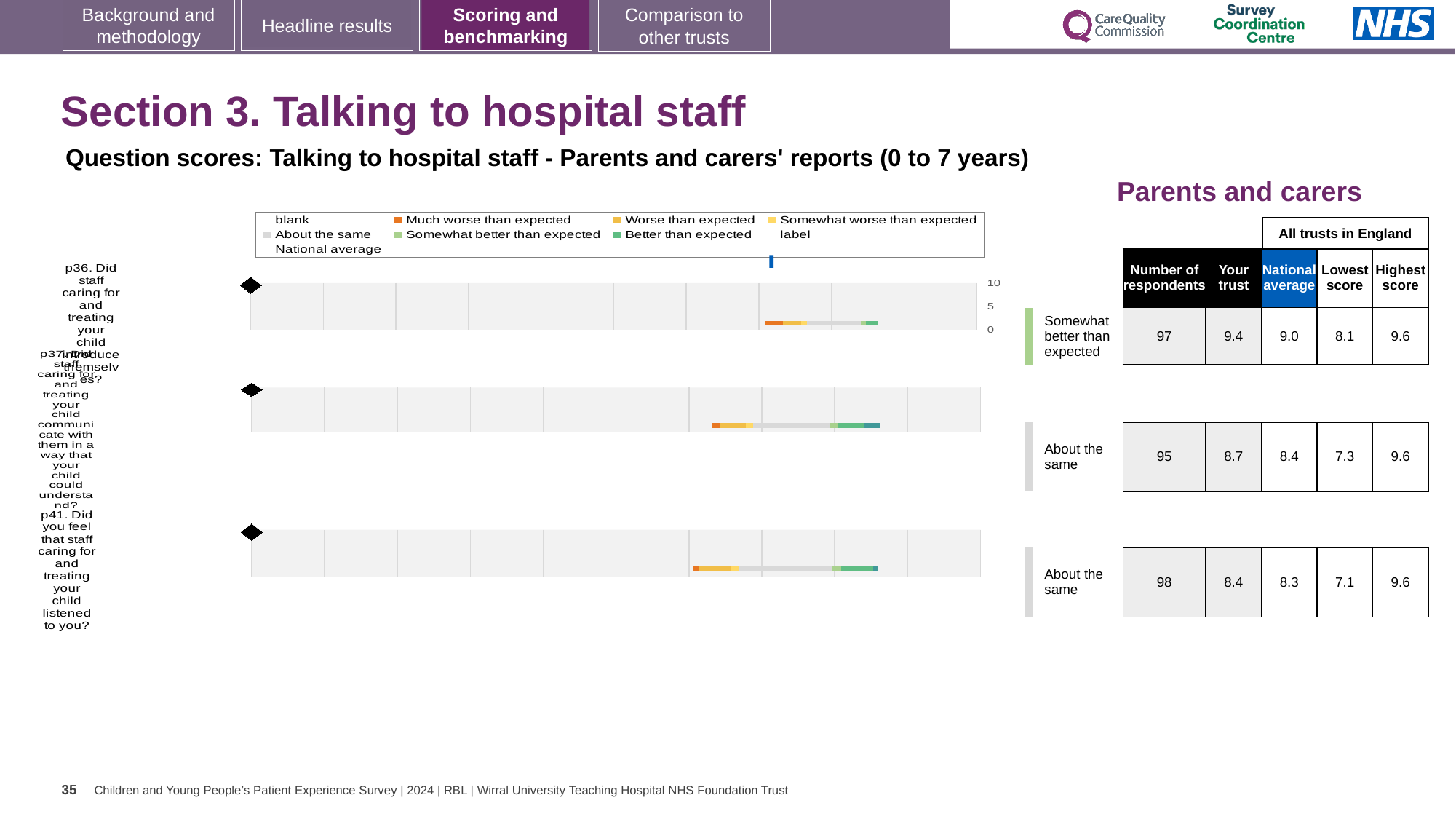
What colour represents 'Much worse than expected' in the legend? orange What is the difference between the 'Your trust' score and the national average for p36? 0.4 How many respondents answered p41 (Did you feel that staff caring for and treating your child listened to you?)? 98 Which benchmark category is p36 placed in? Somewhat better than expected Which question has the lowest number of respondents? p37 What is the national average score for p37 (Did staff communicate with them in a way that your child could understand?)? 8.4 What is the 'Your trust' score for p36 (Did staff caring for and treating your child introduce themselves?)? 9.4 How many entries does the chart legend list? 9 Which question has the highest 'Your trust' score? p36 What is the maximum value shown on the chart's score axis? 10 How many questions (bars) are plotted in the chart? 3 What kind of chart is shown on the slide? bar chart